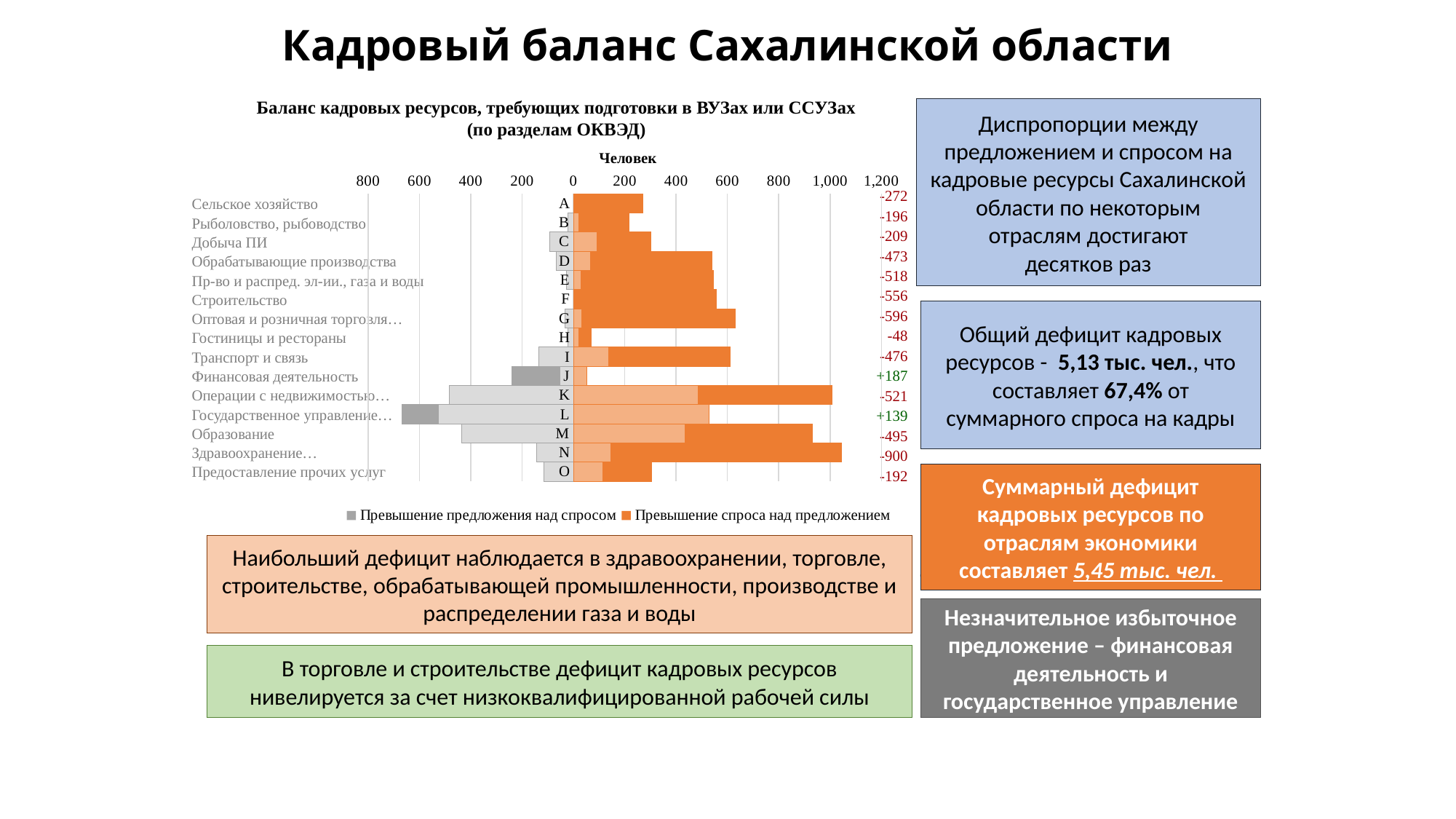
What kind of chart is shown on the slide? Bar chart Which category has the largest deficit (most negative printed balance)? Здравоохранение (N) How many industry categories (sections A–O) are plotted in the chart? 15 What balance value is printed for Здравоохранение (N)? -900 What balance value is printed for Гостиницы и рестораны (H)? -48 What balance value is printed for Финансовая деятельность (J)? +187 What is the difference between the printed balance for Здравоохранение (-900) and Оптовая и розничная торговля (-596)? 304 How many series does the chart legend list? 2 What balance value is printed for Строительство (F)? -556 What unit is shown on the horizontal axis of the chart? Человек Which category has the smallest deficit among the negative printed balances? Гостиницы и рестораны (H) Which has the larger deficit: Обрабатывающие производства (D) or Транспорт и связь (I)? Транспорт и связь (I)